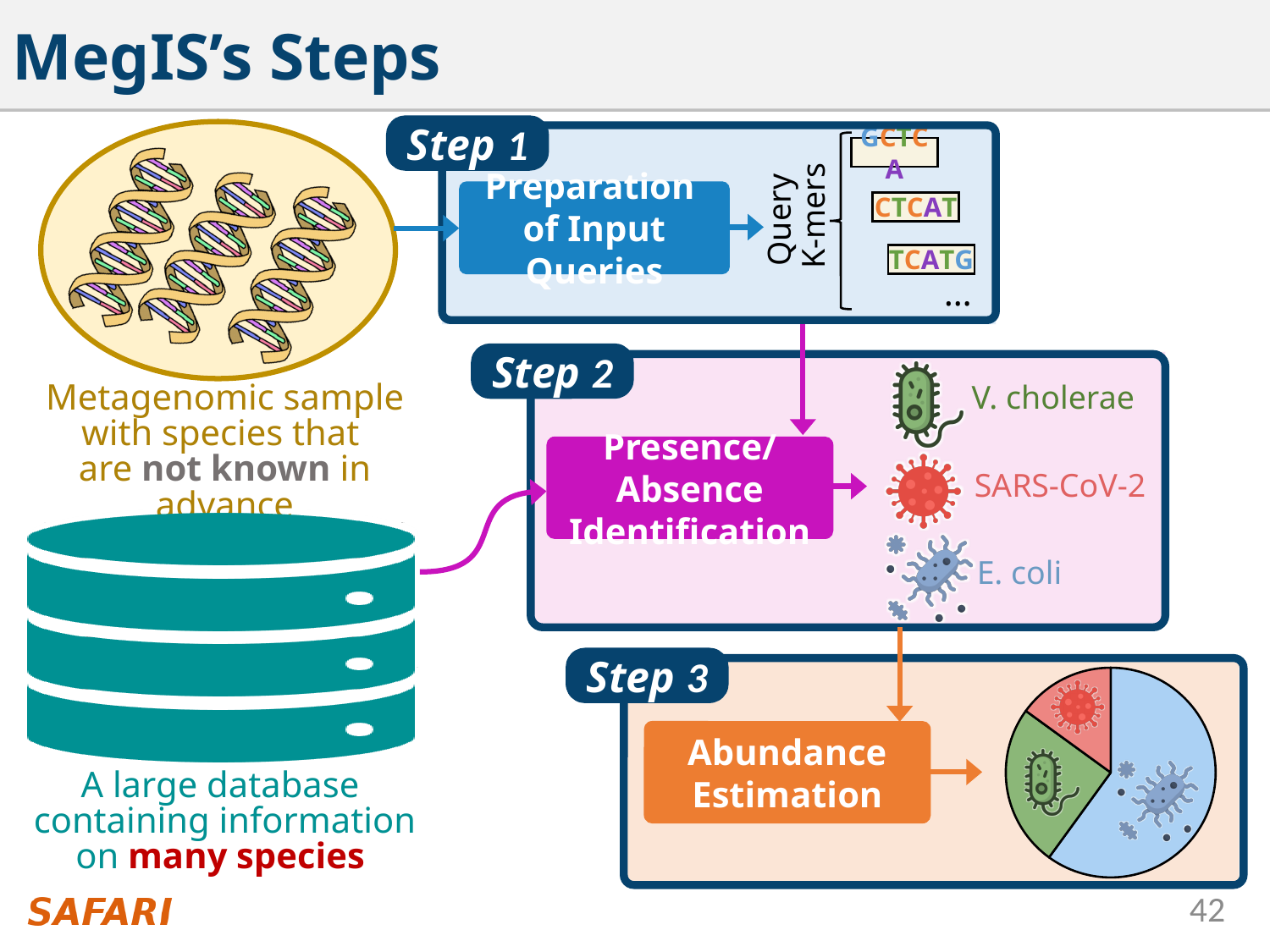
How many slices does the pie chart in Step 3 have? 3 What kind of chart is shown in the Step 3 box of the slide? pie chart In the Step 3 pie chart, is the blue slice larger or smaller than the red slice? larger What colours are the three slices of the pie chart in Step 3? red, green and blue Which slice of the pie chart in Step 3 is the largest? the blue slice Which step of MegIS produces the pie chart shown on the slide? Step 3 (Abundance Estimation) In the Step 3 pie chart, is the blue slice larger or smaller than the green slice? larger